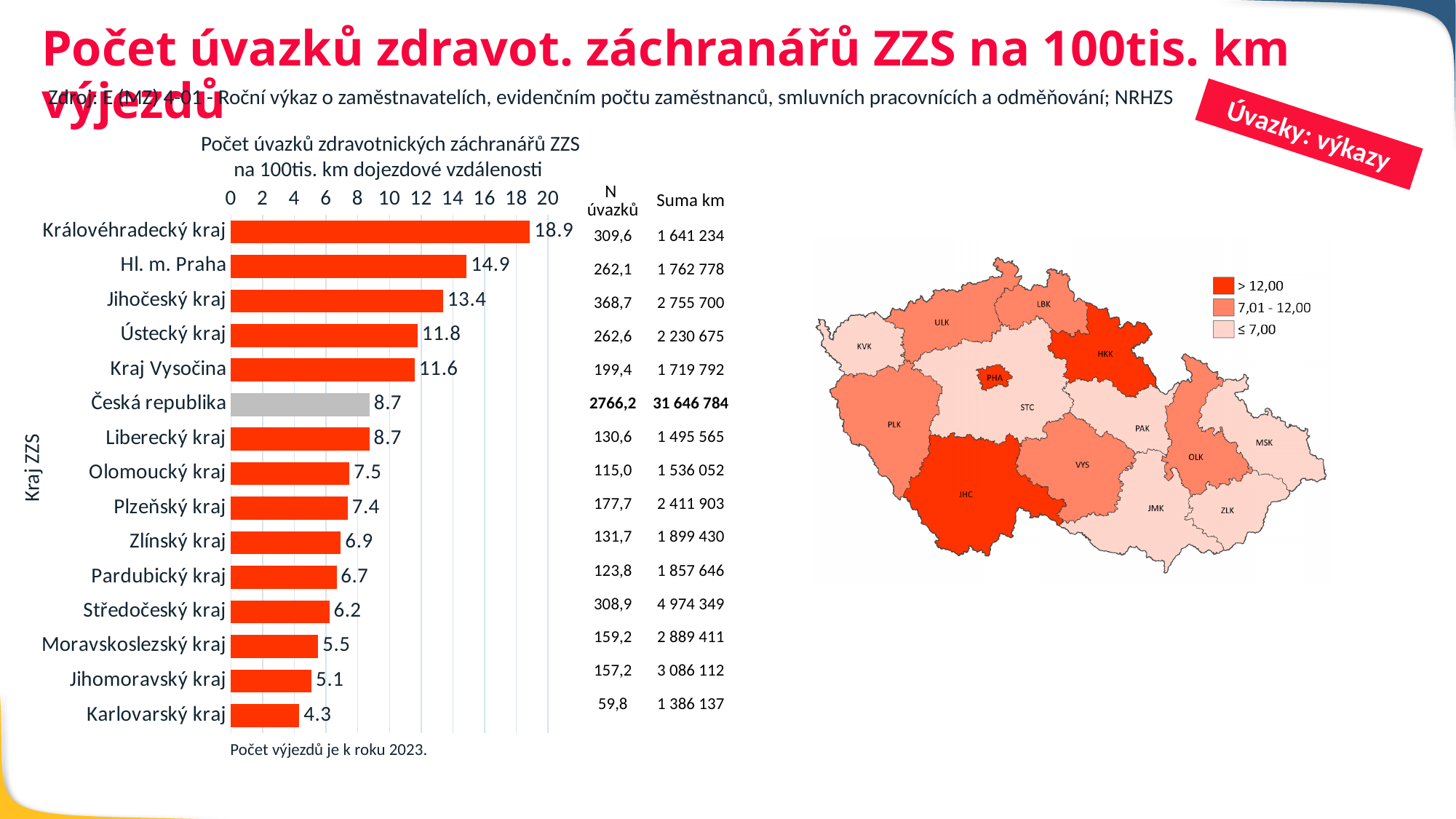
What is the value for Česká republika in the bar chart? 8.7 What is the value for Královéhradecký kraj in the bar chart? 18.9 Is the value for Ústecký kraj greater or less than 10? greater What is the value for Karlovarský kraj in the bar chart? 4.3 Which bar in the bar chart is coloured grey instead of orange-red? Česká republika What is the value for Hl. m. Praha in the bar chart? 14.9 Which category has the highest value in the bar chart? Královéhradecký kraj Which category has the lowest value in the bar chart? Karlovarský kraj How many bars are plotted in the bar chart? 15 What type of chart is shown on the left of the slide? bar chart Which is larger in the bar chart, the value for Jihočeský kraj or the value for Ústecký kraj? Jihočeský kraj What is the difference between the values for Královéhradecký kraj and Karlovarský kraj? 14.6